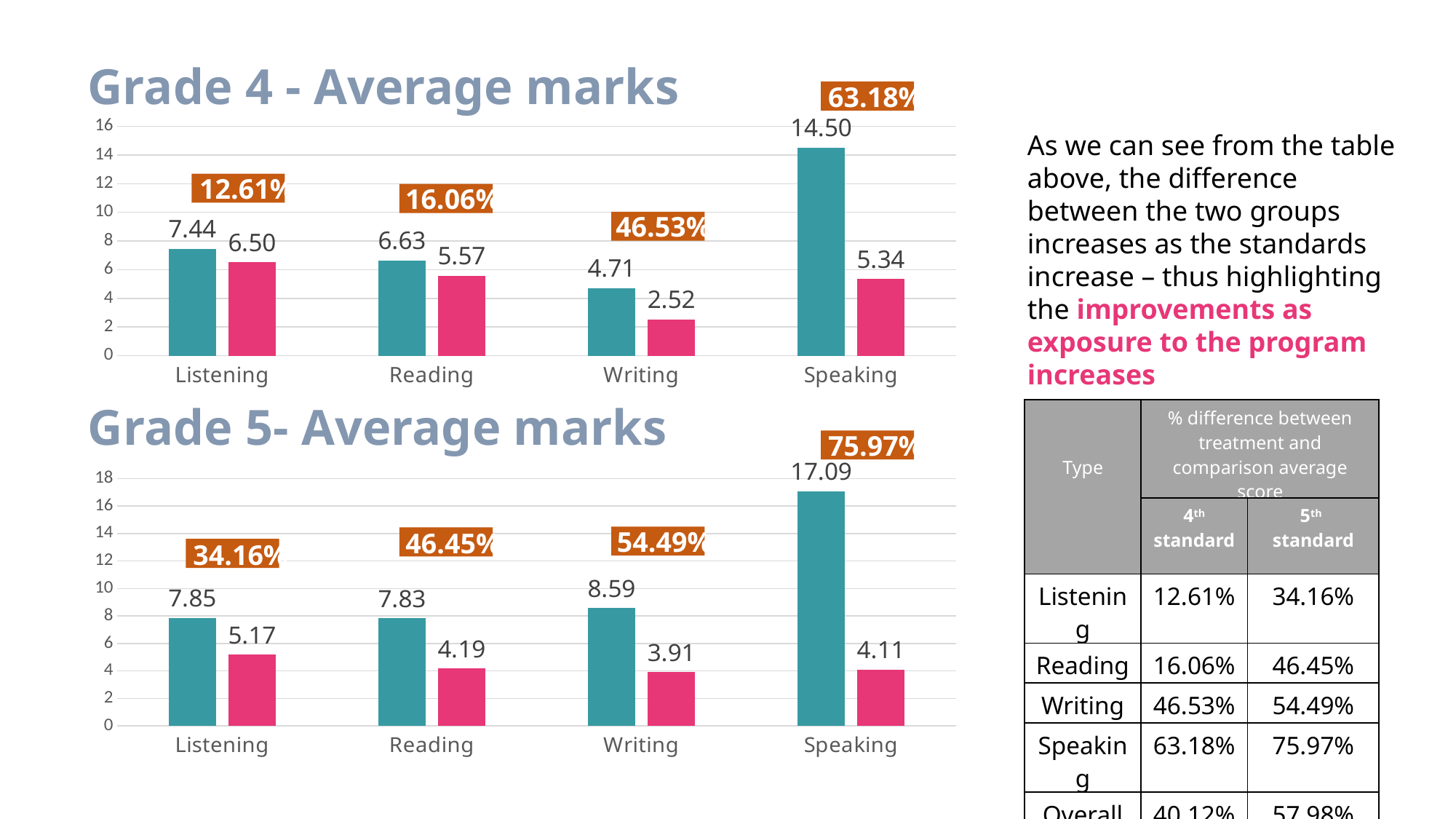
In the Grade 4 - Average marks chart, what is the value of the teal bar for Speaking? 14.50 In the Grade 4 - Average marks chart, what is the difference between the teal and pink bars for Listening? 0.94 In the Grade 5- Average marks chart, what is the difference between the teal and pink bars for Speaking? 12.98 In the Grade 4 - Average marks chart, what is the value of the pink bar for Writing? 2.52 In the Grade 5- Average marks chart, which category has the lowest pink bar? Writing In the Grade 4 - Average marks chart, which category has the highest teal bar? Speaking What type of chart is the Grade 4 - Average marks chart? Bar chart In the Grade 5- Average marks chart, what is the value of the teal bar for Writing? 8.59 In the Grade 5- Average marks chart, what percentage label is shown above the Speaking bars? 75.97% How many categories are shown on the x axis of the Grade 5- Average marks chart? 4 In the Grade 5- Average marks chart, what is the value of the pink bar for Reading? 4.19 In the Grade 4 - Average marks chart, which is larger: the pink bar for Listening or the pink bar for Speaking? Listening